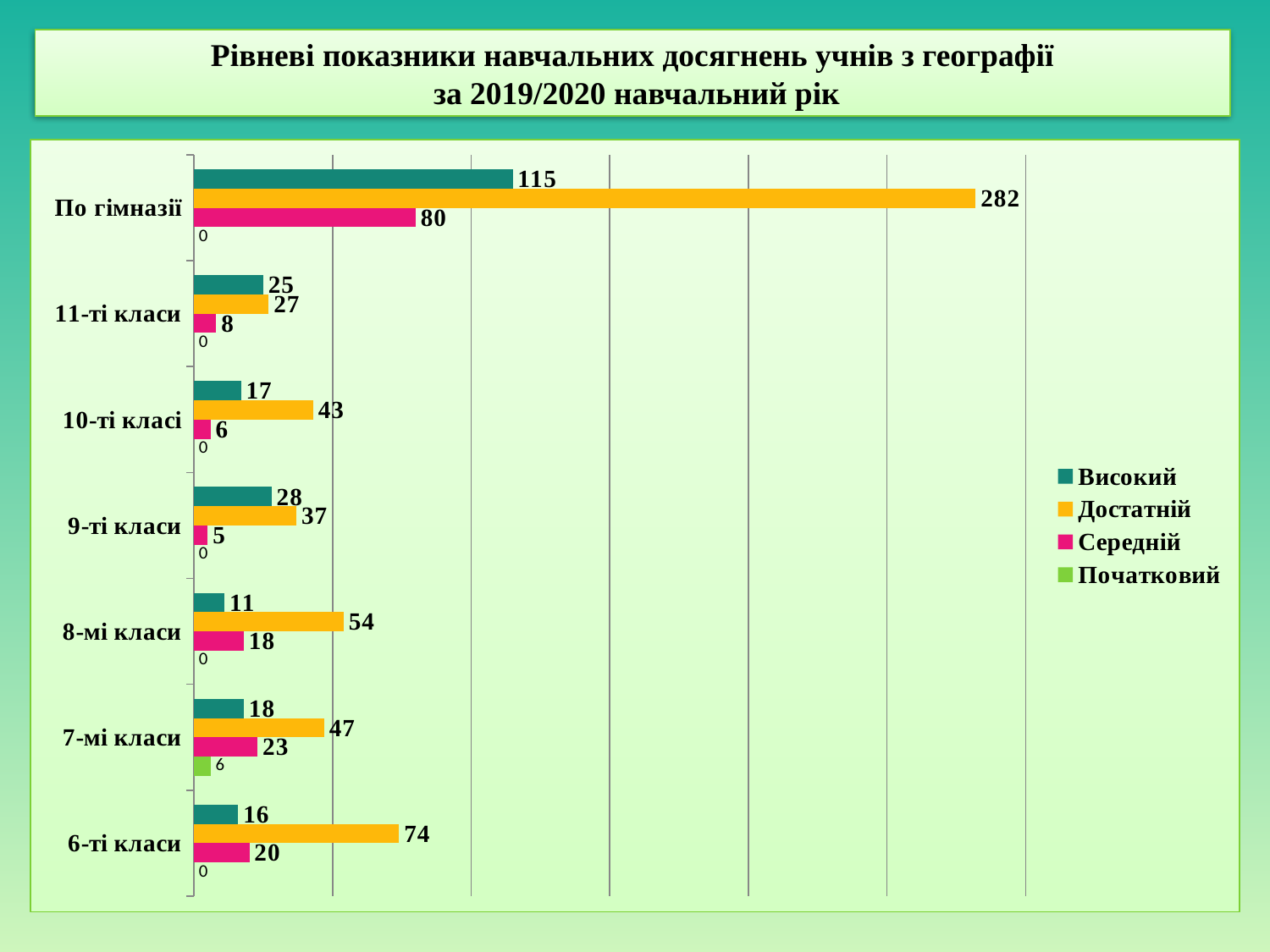
What type of chart is shown on the slide? bar chart How many categories are shown on the vertical axis? 7 What is the value of Початковий for 7-мі класи? 6 How many series does the legend list? 4 What is the value of Високий for 9-ті класи? 28 Which series is shown in pink/magenta in the legend? Середній What is the value of Середній for 8-мі класи? 18 What is the value of Достатній for По гімназії? 282 What is the difference between the Достатній and Високий values for 10-ті класі? 26 Which class category has the highest Достатній value (excluding По гімназії)? 6-ті класи Which class category has the lowest Середній value? 9-ті класи Which is larger for 11-ті класи: Високий or Достатній? Достатній